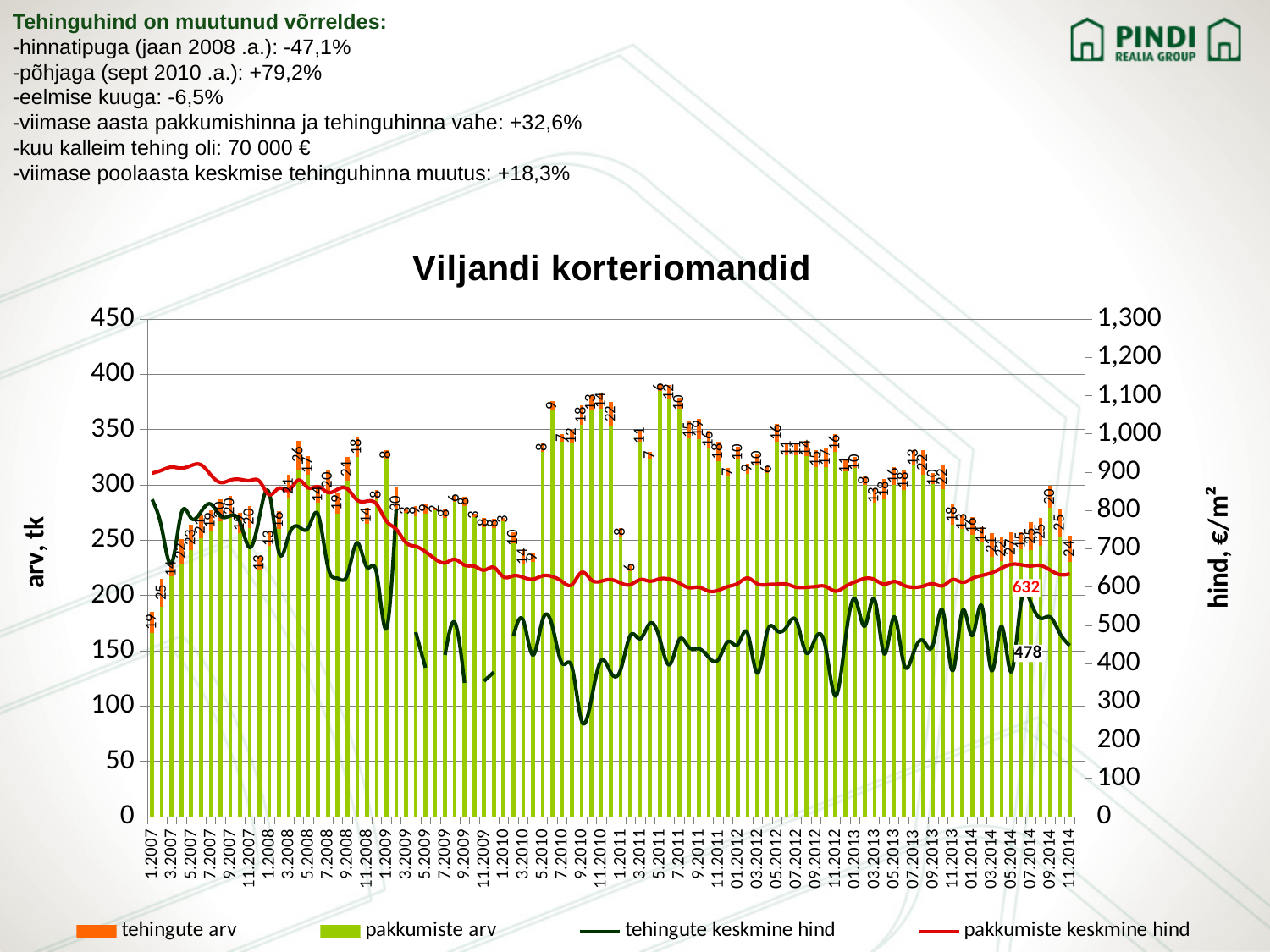
Does the pakkumiste keskmine hind line rise or fall from 1.2007 to 1.2010? fall What is the difference between the two labelled values 632 and 478 on the tehingute keskmine hind line? 154 Which is larger, the pakkumiste arv for 5.2011 or for 1.2007? 5.2011 Is the pakkumiste arv value for 5.2011 greater or less than 350? greater How many series does the chart legend list? 4 What kind of chart is this? Combined bar and line chart What is the label of the right-hand vertical axis? hind, €/m² Is the pakkumiste keskmine hind value at 1.2007 greater or less than 800? greater What is the labelled low value of the tehingute keskmine hind line shown near the end of the series? 478 Is the tehingute keskmine hind value around 9.2010 greater or less than 300? less What is the title of the chart? Viljandi korteriomandid